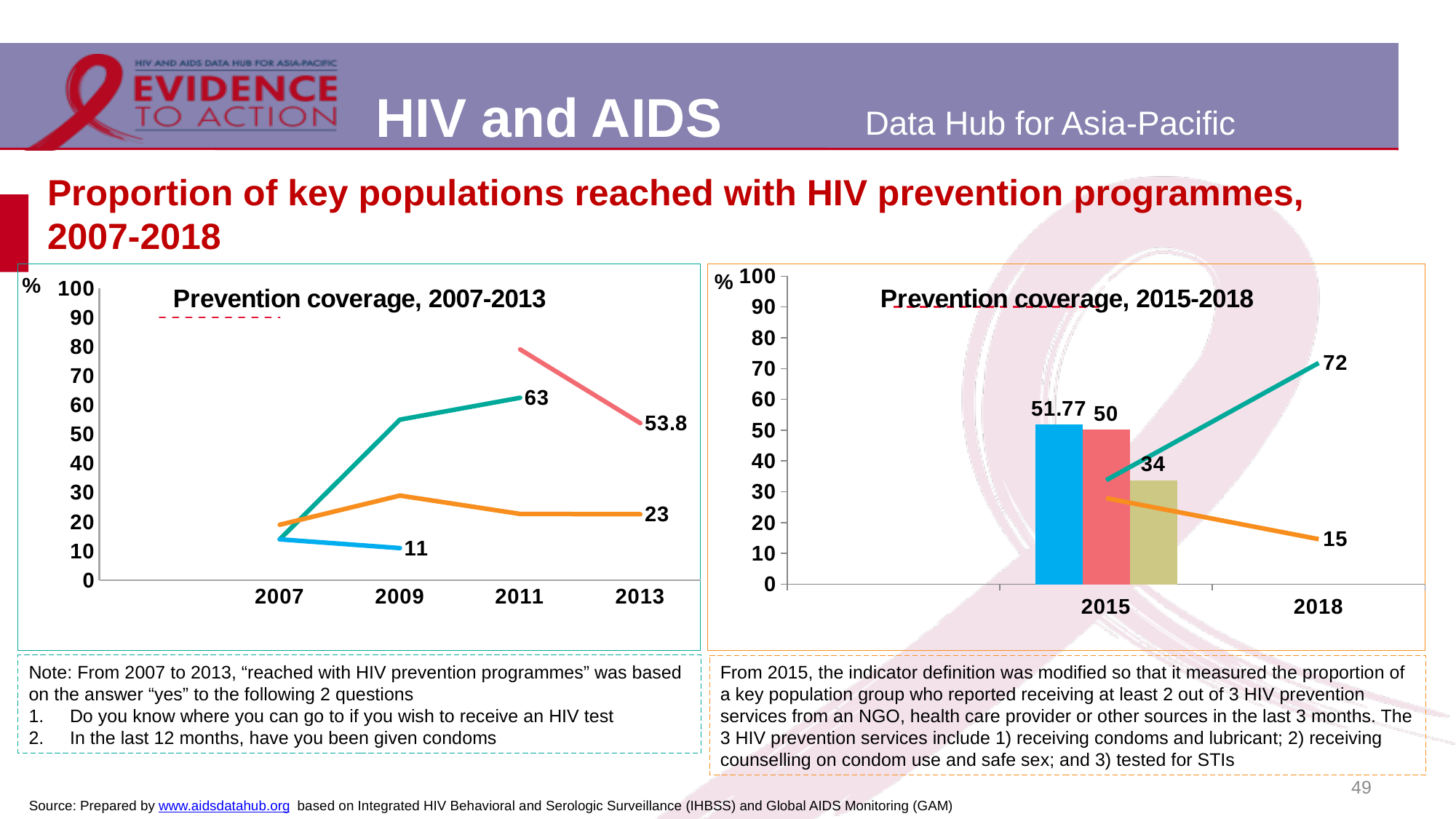
What kind of chart is the left chart, Prevention coverage 2007-2013? line chart In the left chart, Prevention coverage 2007-2013, what value is labelled on the teal line at 2011? 63 In the left chart, Prevention coverage 2007-2013, how many years are shown on the x axis? 4 In the right chart, Prevention coverage 2015-2018, what is the value of the tallest bar at 2015? 51.77 In the left chart, Prevention coverage 2007-2013, what value is labelled on the blue line at 2009? 11 In the left chart, Prevention coverage 2007-2013, is the value of the red line at 2011 greater or less than 70? greater In the right chart, Prevention coverage 2015-2018, what is the value of the shortest bar at 2015? 34 In the left chart, Prevention coverage 2007-2013, what value is labelled on the orange line at 2013? 23 In the left chart, Prevention coverage 2007-2013, what is the difference between the red line's value and the orange line's value at 2013? 30.8 In the left chart, Prevention coverage 2007-2013, what value is labelled on the red line at 2013? 53.8 In the right chart, Prevention coverage 2015-2018, what is the difference between the teal line's value and the orange line's value at 2018? 57 In the right chart, Prevention coverage 2015-2018, does the orange line rise or fall from 2015 to 2018? fall